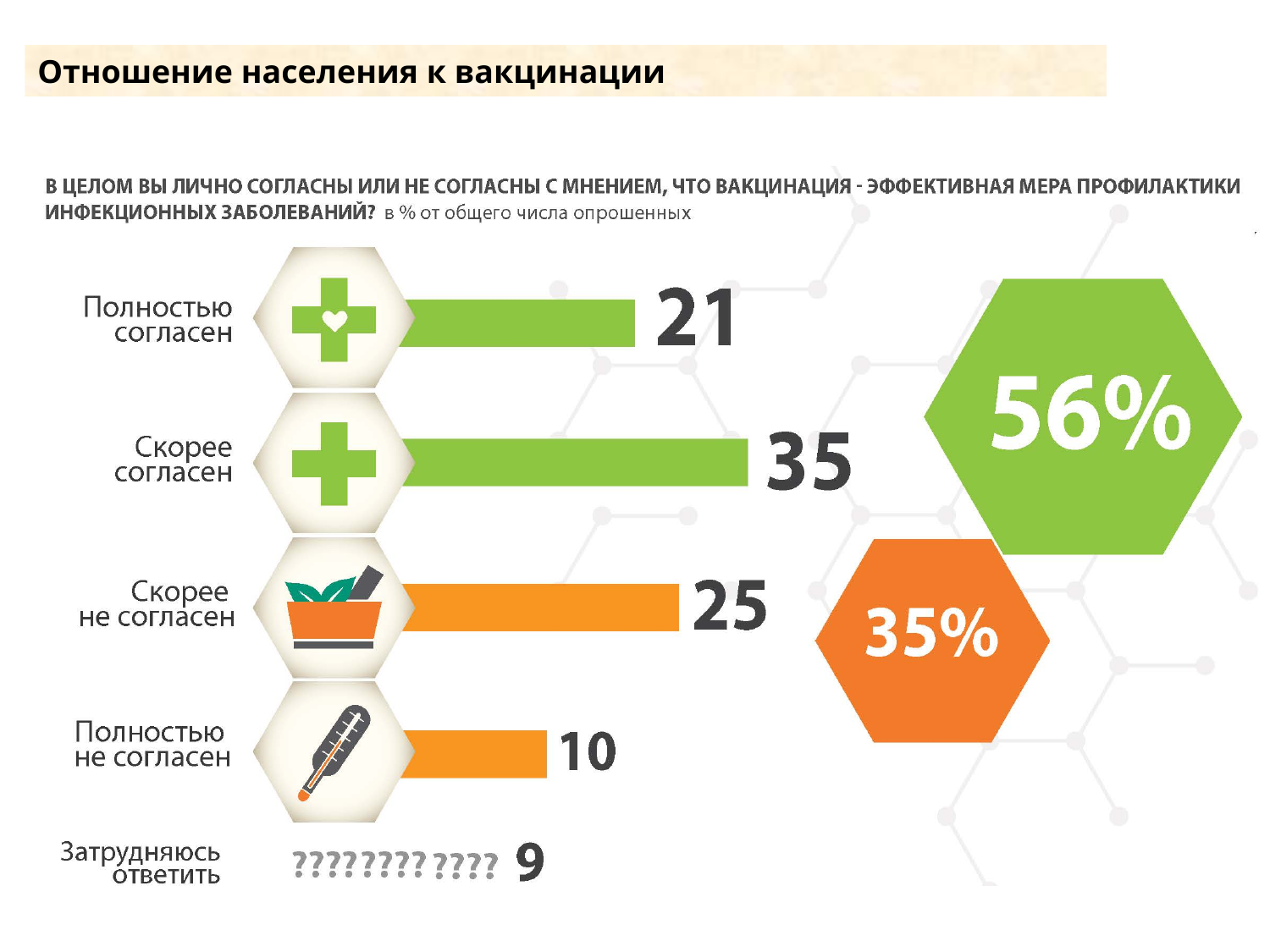
How many answer categories are shown in the chart? 5 What is the difference between the values for "Скорее согласен" and "Полностью согласен"? 14 Which category has the highest value? Скорее согласен What value is shown for "Полностью не согласен"? 10 What kind of chart is shown on the slide? bar chart What percentage is shown in the large green hexagon? 56% Which is larger, the value for "Полностью согласен" or the value for "Скорее не согласен"? Скорее не согласен What percentage is shown in the orange hexagon? 35% What value is shown for "Затрудняюсь ответить"? 9 Which category has the lowest value? Затрудняюсь ответить What value is shown for "Скорее согласен"? 35 What is the difference between the values for "Скорее не согласен" and "Полностью не согласен"? 15